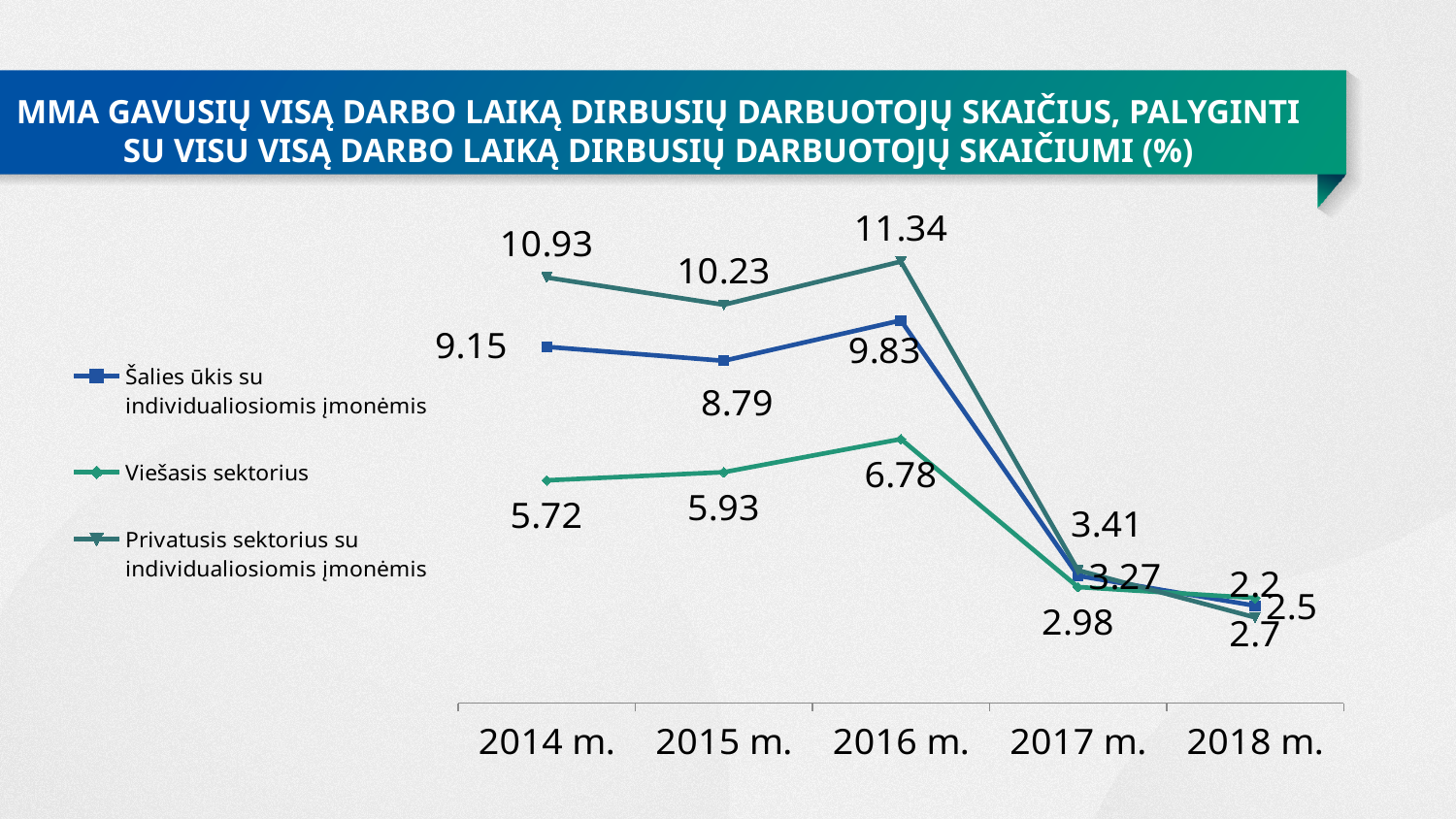
How many years are shown on the x axis? 5 What is the value for Privatusis sektorius su individualiosiomis įmonėmis in 2016 m.? 11.34 Which series has the lowest value in 2017 m.? Viešasis sektorius How many series does the legend list? 3 What is the value for Šalies ūkis su individualiosiomis įmonėmis in 2015 m.? 8.79 What kind of chart is shown on the slide? line chart Do the values for Privatusis sektorius su individualiosiomis įmonėmis rise or fall from 2016 m. to 2017 m.? fall What is the value for Šalies ūkis su individualiosiomis įmonėmis in 2017 m.? 3.27 In which year does Privatusis sektorius su individualiosiomis įmonėmis reach its highest value? 2016 m. In 2014 m., which is larger: Šalies ūkis su individualiosiomis įmonėmis or Viešasis sektorius? Šalies ūkis su individualiosiomis įmonėmis What is the difference between Privatusis sektorius su individualiosiomis įmonėmis and Viešasis sektorius in 2016 m.? 4.56 What is the value for Viešasis sektorius in 2014 m.? 5.72